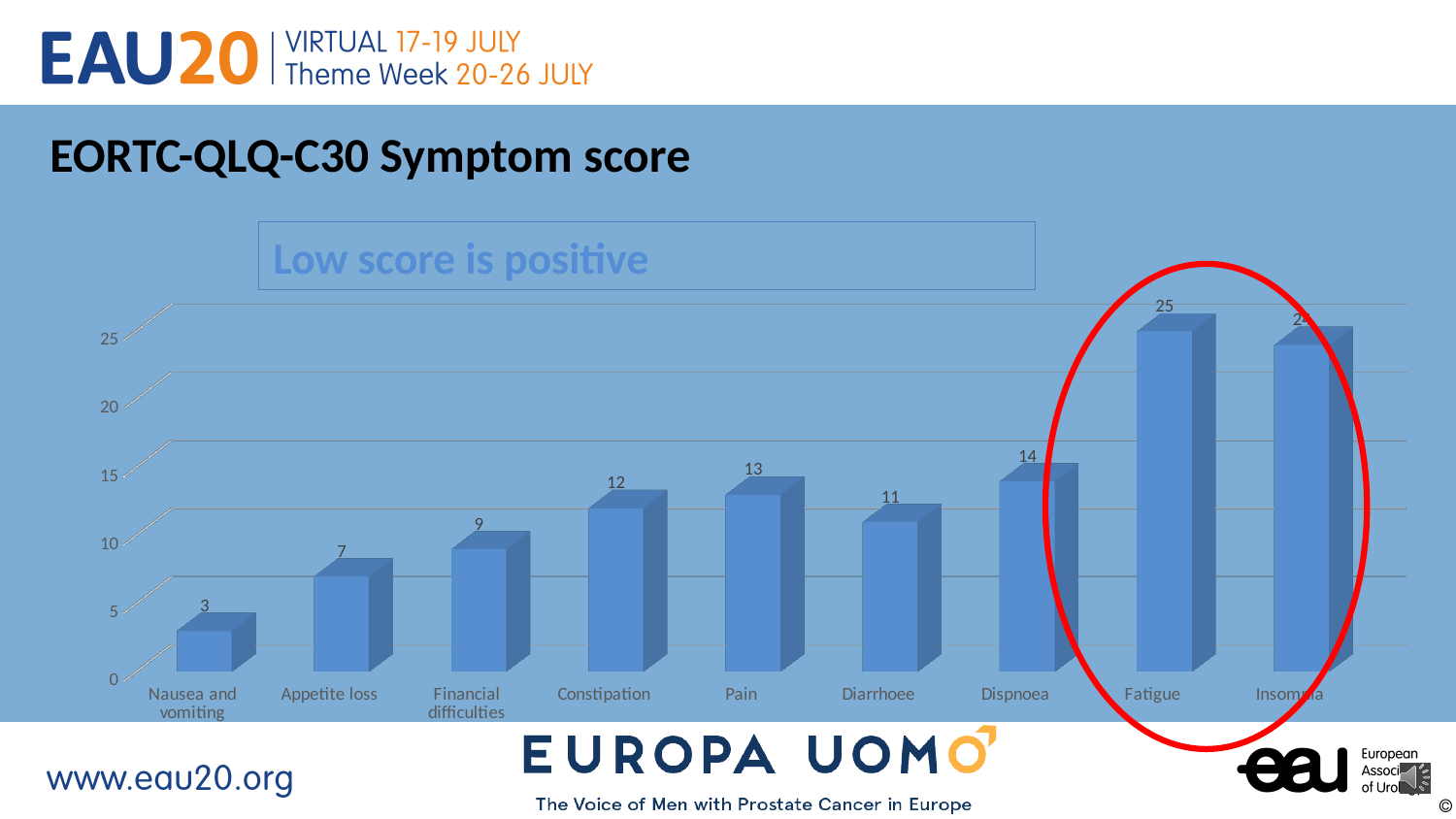
What is the value for Nausea and vomiting? 3 What is the difference between the values for Pain and Diarrhoee? 2 How many categories are shown on the x axis? 9 What is the title of the chart on the slide? EORTC-QLQ-C30 Symptom score What is the value for Appetite loss? 7 Is the value for Insomnia greater or less than 20? greater What is the value for Fatigue? 25 What kind of chart is shown on the slide? Bar chart What is the value for Financial difficulties? 9 Which is larger, the value for Dispnoea or the value for Constipation? Dispnoea Which category has the lowest value? Nausea and vomiting What is the value for Constipation? 12